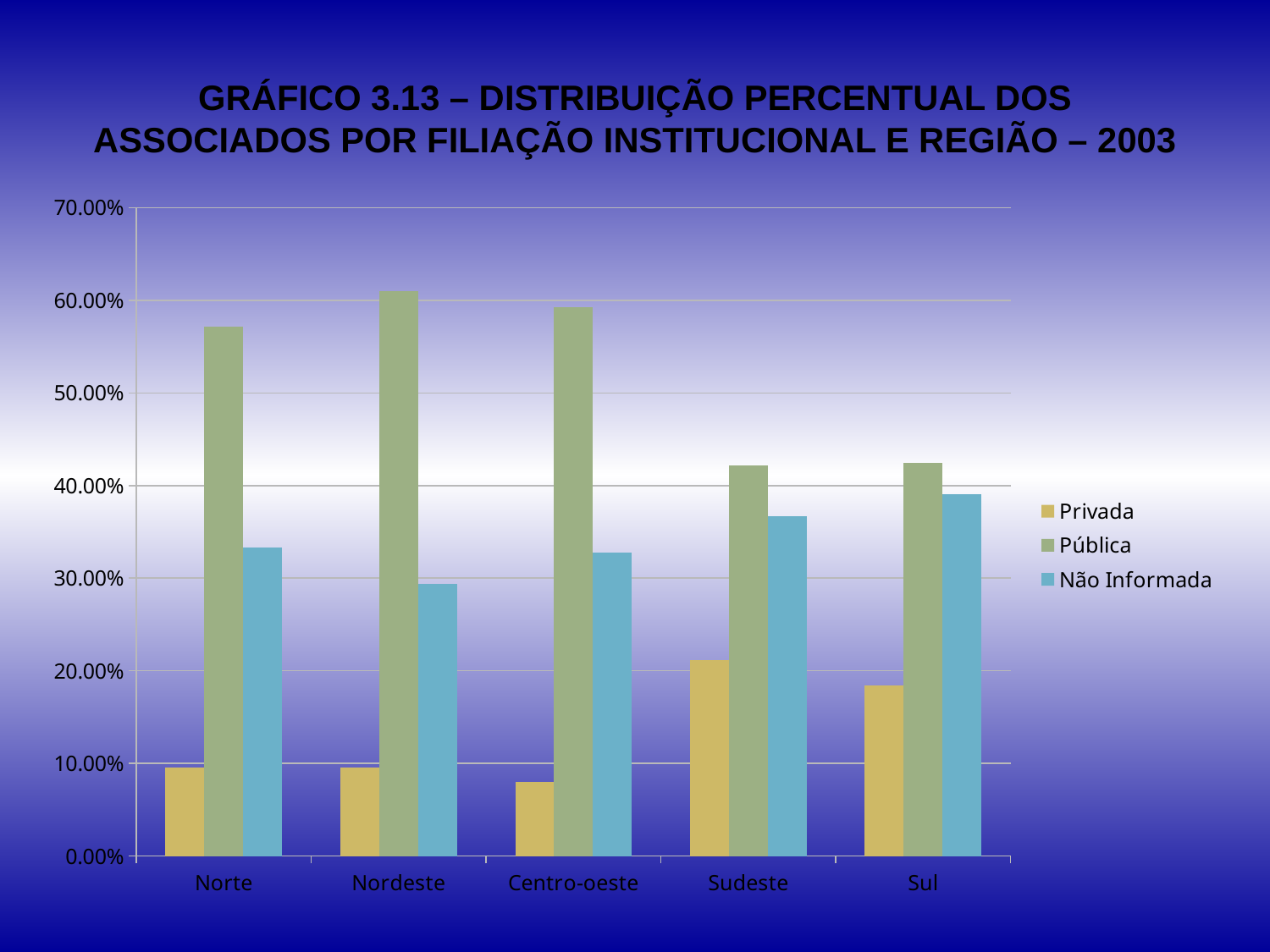
What kind of chart is shown on the slide? Bar chart Which region has the highest value for Não Informada? Sul Which region has the highest value for Privada? Sudeste Is the value for Pública in Nordeste greater or less than 60.00%? greater How many series does the legend list? 3 Is the value for Não Informada in Nordeste greater or less than 30.00%? less Which region has the lowest value for Privada? Centro-oeste Is the value for Privada in Norte greater or less than 10.00%? less How many regions are shown on the x axis? 5 Which region has the highest value for Pública? Nordeste Which series is shown in blue in the legend? Não Informada In Sudeste, which is larger: Pública or Não Informada? Pública